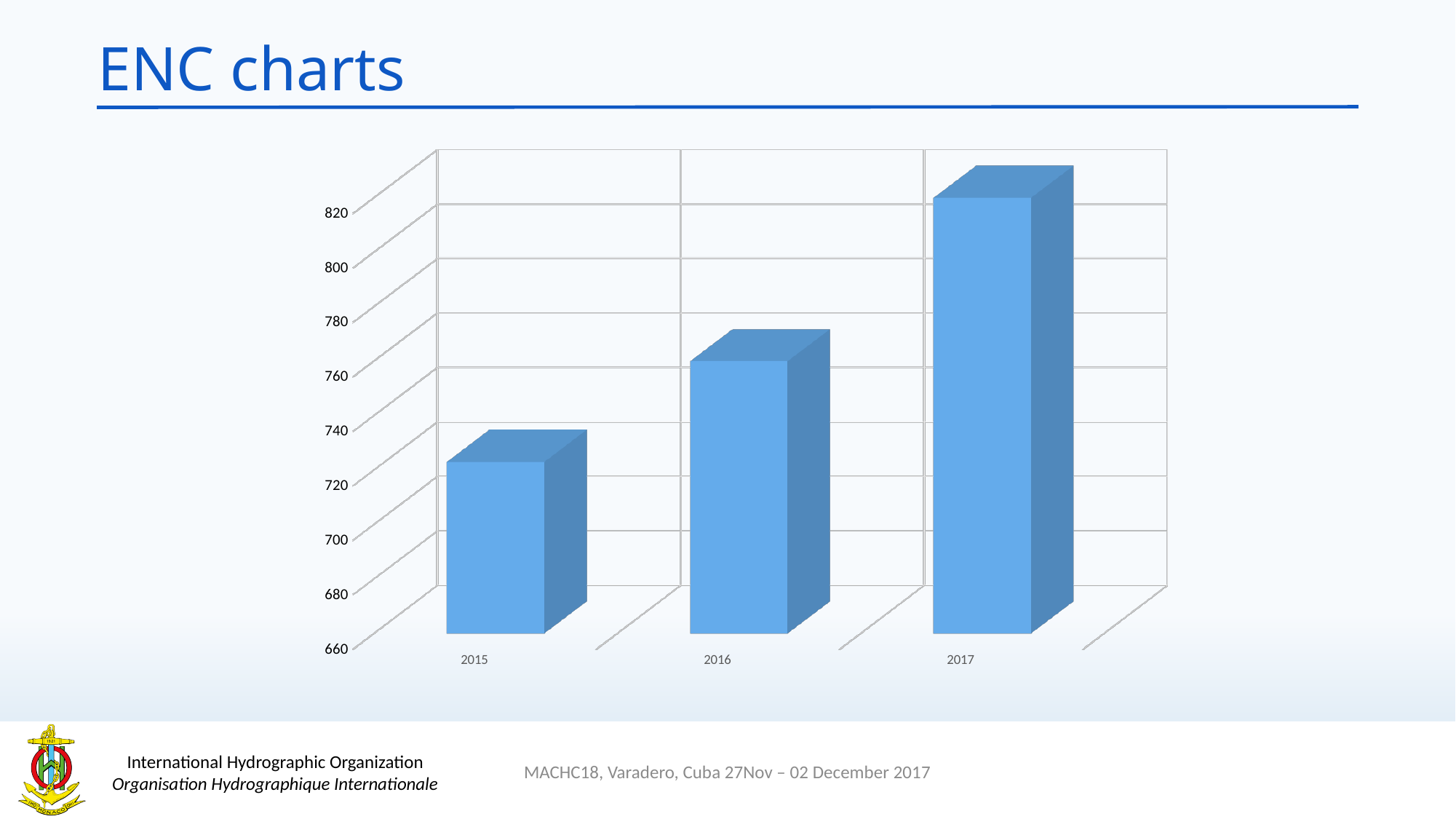
Which is larger, the value for 2016 or the value for 2015? 2016 How many years are plotted on the chart? 3 Is the value for 2016 greater or less than 780? less Is the value for 2015 greater or less than 740? less Do the values rise or fall from 2015 to 2017? Rise Is the value for 2015 greater or less than 700? greater What kind of chart is shown on the slide? Bar chart Which year has the lowest value on the chart? 2015 Which year has the highest value on the chart? 2017 What is the title of the slide containing the chart? ENC charts